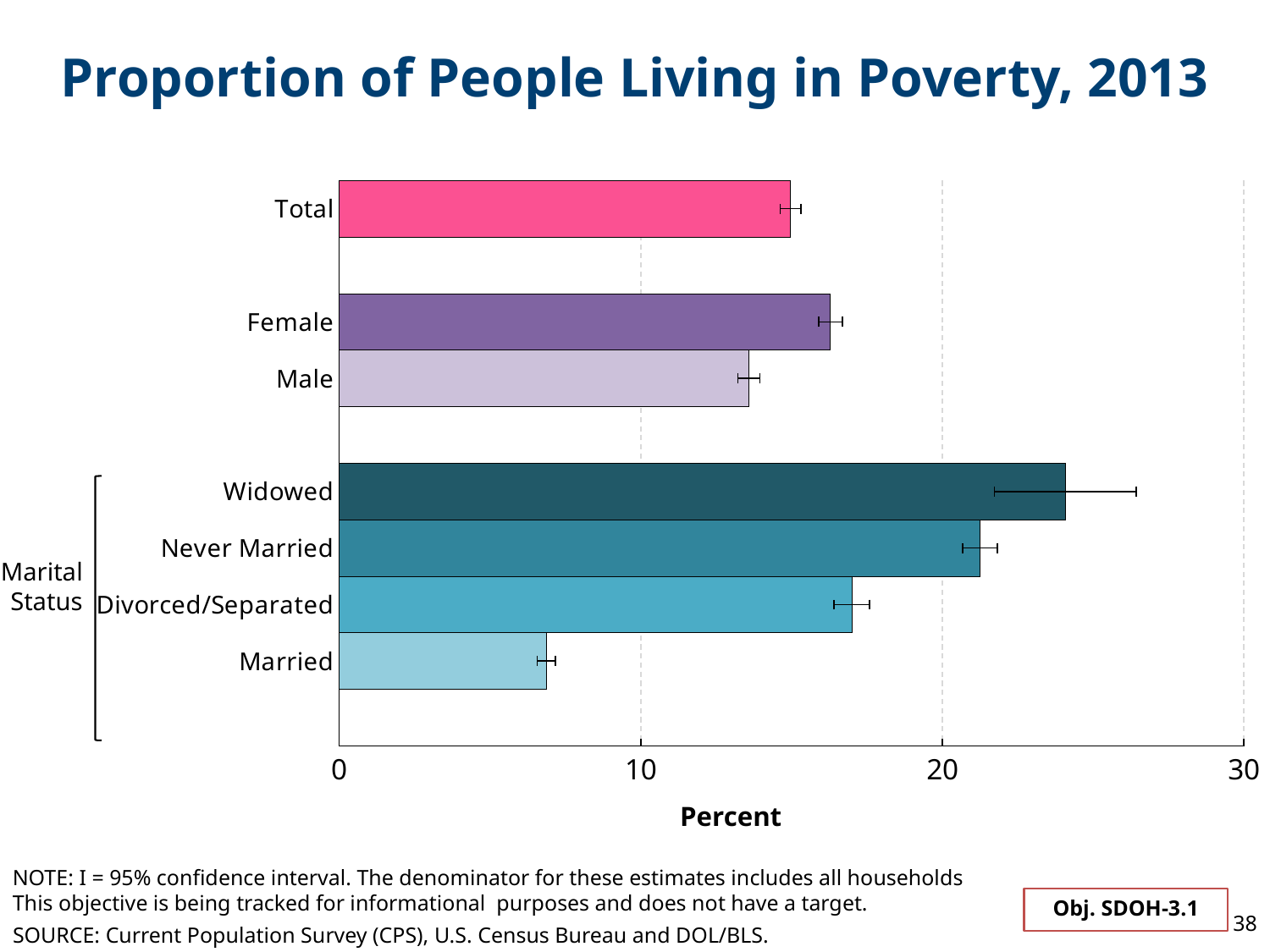
Which is larger, the value for Divorced/Separated or the value for Never Married? Never Married What is the title of the chart? Proportion of People Living in Poverty, 2013 How many bars are plotted in the chart? 7 What kind of chart is shown on the slide? bar chart What is the label on the horizontal axis? Percent Is the value for Widowed greater or less than 20? greater Which category has the highest proportion of people living in poverty? Widowed Which is larger, the value for Female or the value for Male? Female Which category has the lowest proportion of people living in poverty? Married Is the value for Male greater or less than 10? greater Is the value for Married greater or less than 10? less